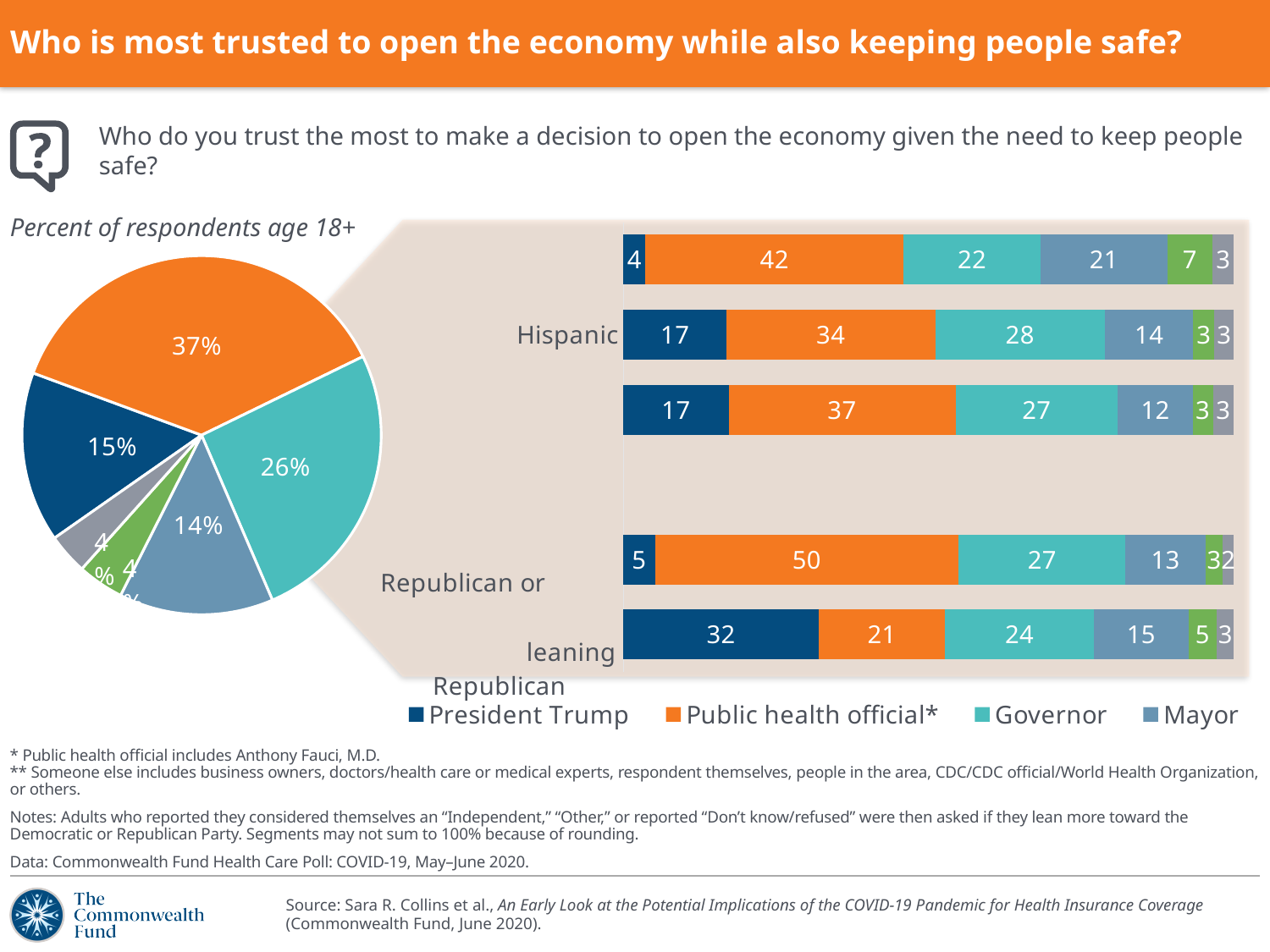
In the pie chart, what share of respondents trust the governor the most? 26% In the pie chart, how many percentage points larger is the public health official slice than the governor slice? 11 In the pie chart, what share of respondents trust a public health official the most? 37% In the bar chart, what is the value for Governor among Hispanic respondents? 28 In the bar chart, what is the value for Public health official among Hispanic respondents? 34 What kind of chart is shown on the left side of the slide? Pie chart In the bar chart, for Hispanic respondents, which is larger: Public health official or Governor? Public health official In the bar chart, what is the value for President Trump among Hispanic respondents? 17 In the pie chart, what is the largest slice's value? 37% What kind of chart is shown on the right side of the slide? Bar chart In the pie chart, what share of respondents trust President Trump the most? 15%